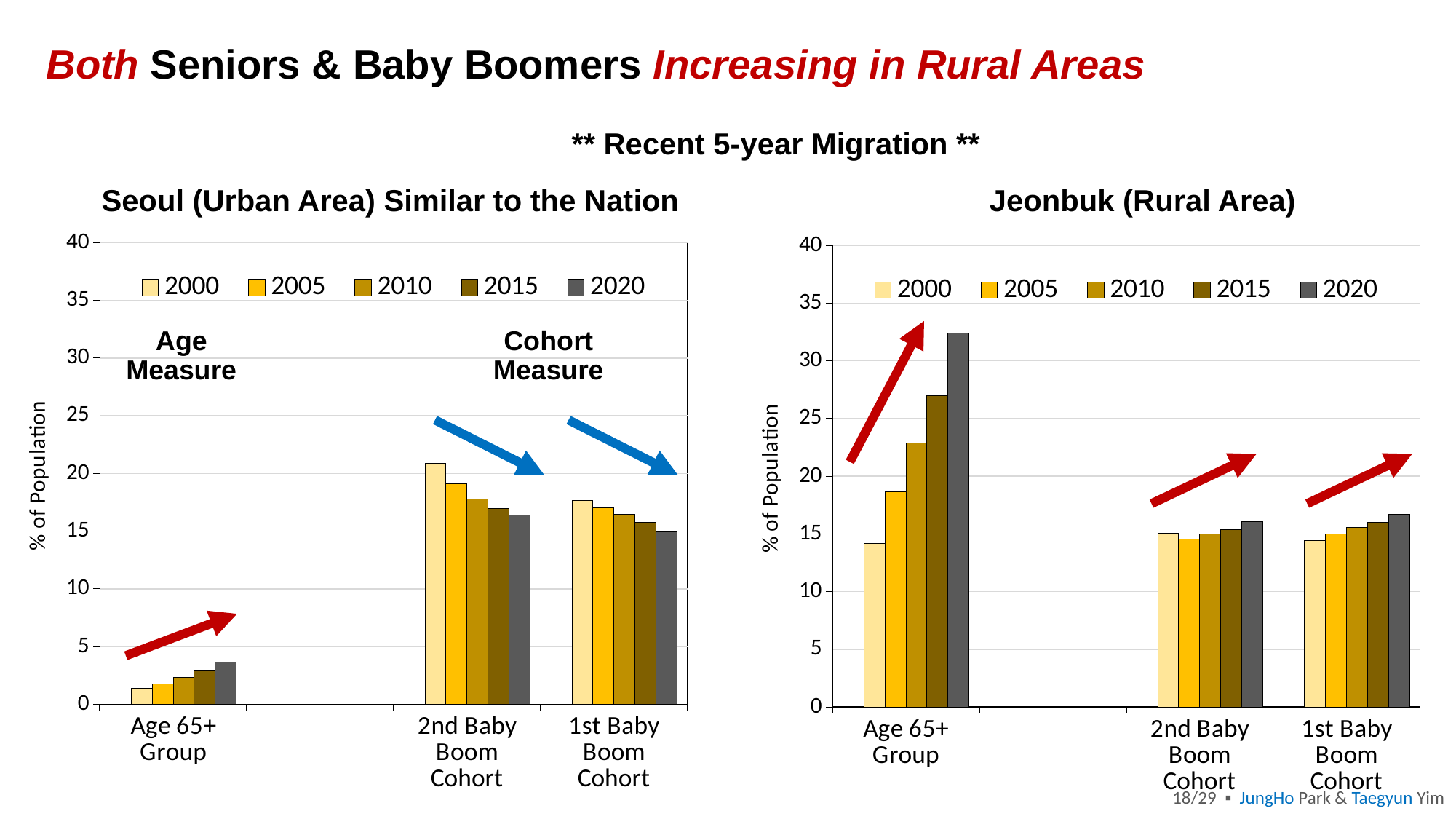
How many series does the legend of the Jeonbuk (Rural Area) chart list? 5 In the Jeonbuk (Rural Area) chart, is the 2000 value for the Age 65+ Group greater or less than 15? less What kind of chart is the Seoul (Urban Area) chart on the left? bar chart How many categories are shown on the x axis of the Seoul (Urban Area) chart? 3 In the Seoul (Urban Area) chart, is the 2000 value for the 2nd Baby Boom Cohort greater or less than 20? greater In the Seoul (Urban Area) chart, do the values for the 2nd Baby Boom Cohort rise or fall from 2000 to 2020? fall In the Jeonbuk (Rural Area) chart, which year has the highest value for the Age 65+ Group? 2020 In the Jeonbuk (Rural Area) chart, which is larger in 2020: the Age 65+ Group or the 2nd Baby Boom Cohort? Age 65+ Group In the Seoul (Urban Area) chart, is the 2020 value for the Age 65+ Group greater or less than 5? less In the Seoul (Urban Area) chart, which year has the lowest value for the 1st Baby Boom Cohort? 2020 In the Jeonbuk (Rural Area) chart, do the values for the Age 65+ Group rise or fall from 2000 to 2020? rise